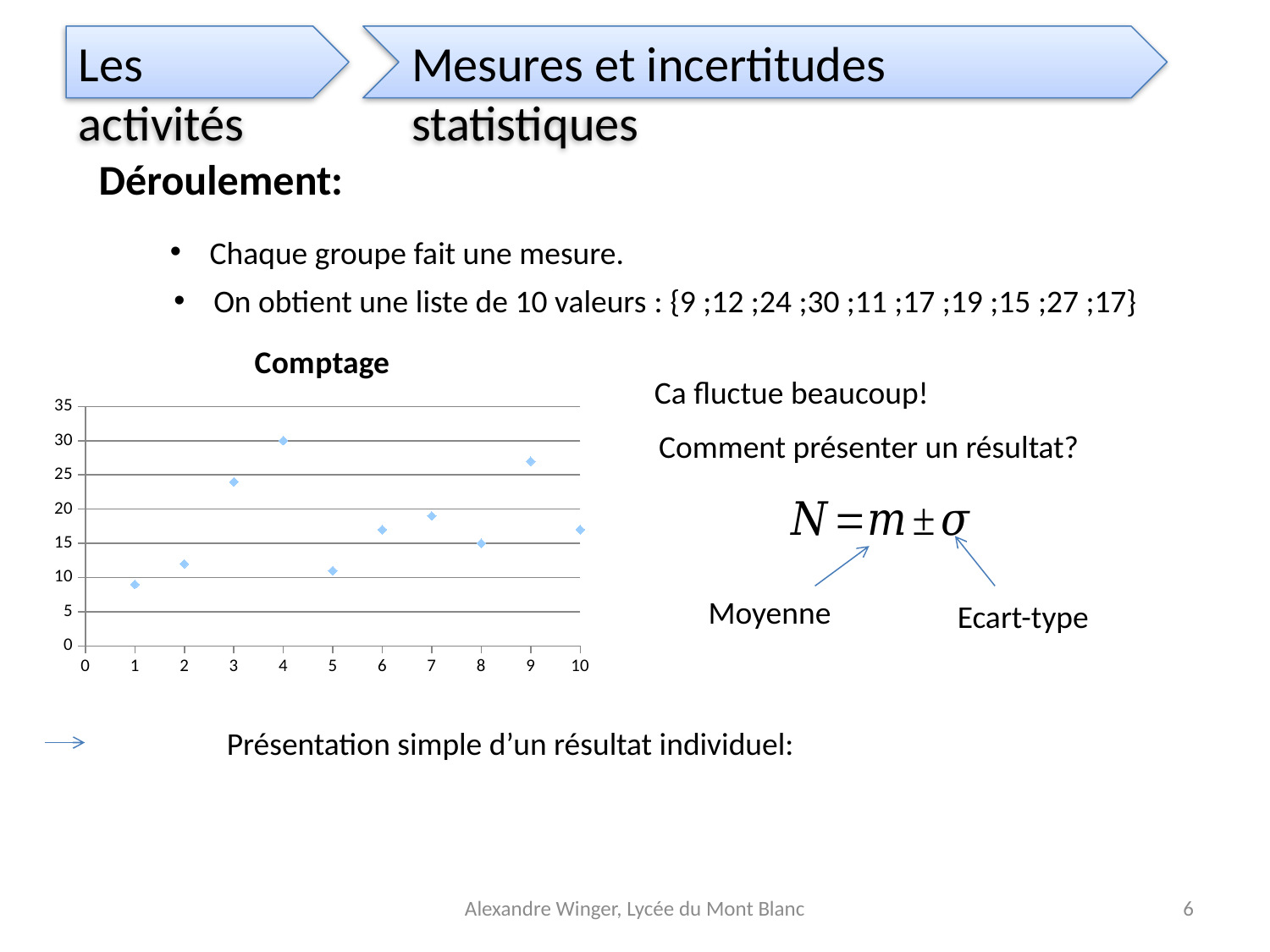
How many data points are plotted in the Comptage chart? 10 Which x value has the lowest point in the Comptage chart? 1 In the Comptage chart, which point is higher: x = 9 or x = 6? x = 9 Is the value at x = 5 in the Comptage chart greater or less than 15? less Which x value has the highest point in the Comptage chart? 4 What is the title of the chart? Comptage What is the value of the point at x = 4 in the Comptage chart? 30 What is the maximum value shown on the y axis of the Comptage chart? 35 What is the difference between the values at x = 4 and x = 8 in the Comptage chart? 15 Is the value at x = 3 in the Comptage chart greater or less than 20? greater What is the value of the point at x = 8 in the Comptage chart? 15 What kind of chart is shown on the slide? scatter chart